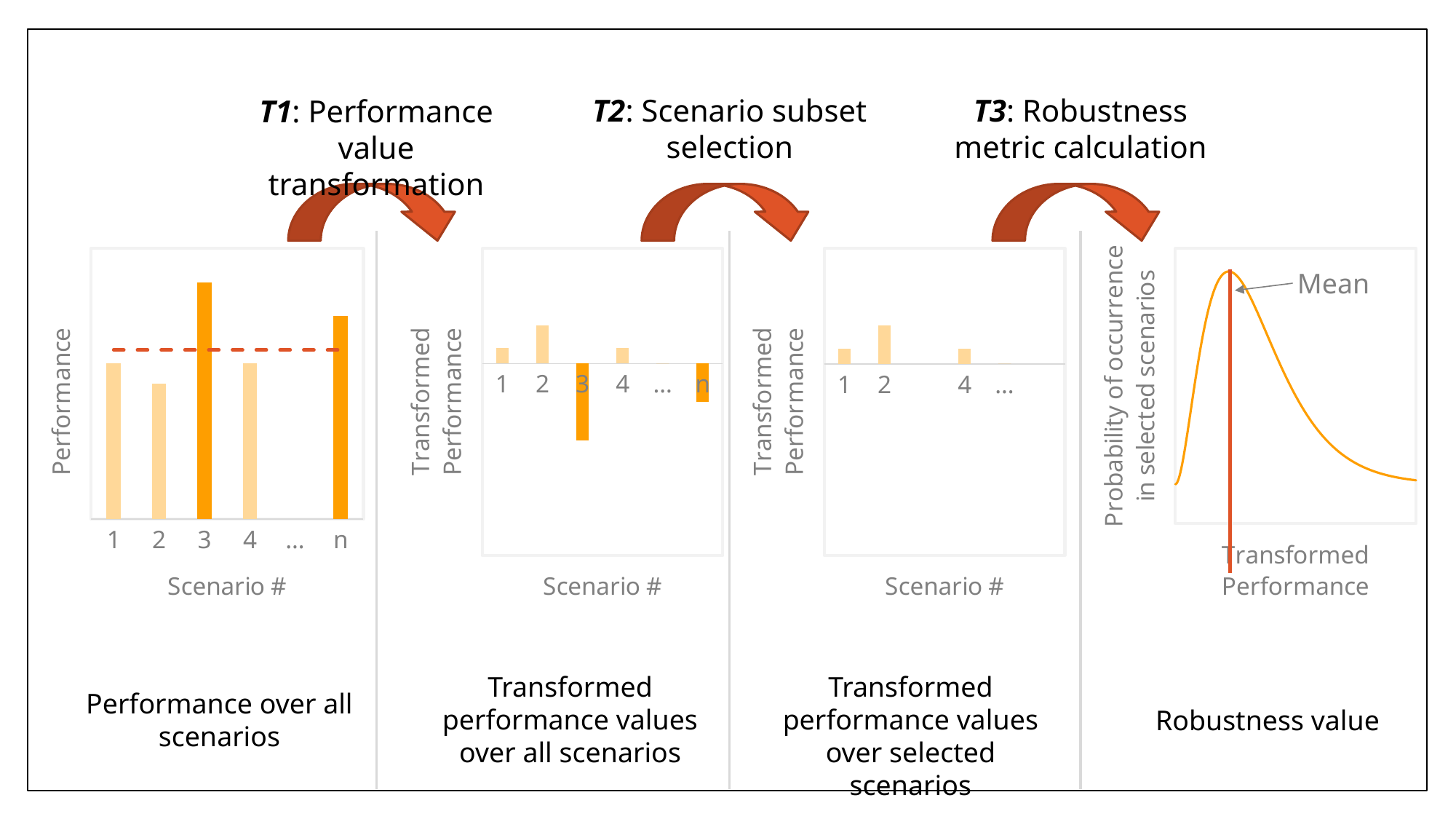
What is the y-axis label of the chart titled 'Robustness value'? Probability of occurrence in selected scenarios In the chart titled 'Transformed performance values over all scenarios', which scenario has the highest bar? 2 In the chart titled 'Transformed performance values over all scenarios', which scenario has the lowest (most negative) bar? 3 What kind of chart is the chart titled 'Robustness value'? Line chart In the chart titled 'Transformed performance values over selected scenarios', which scenario has the highest bar? 2 What kind of chart is the chart titled 'Performance over all scenarios'? Bar chart In the chart titled 'Performance over all scenarios', which scenario has the highest performance bar? 3 In the chart titled 'Transformed performance values over all scenarios', is the bar for scenario n above or below zero? Below In the chart titled 'Performance over all scenarios', which scenario has the lowest performance bar? 2 How many scenario bars are shown in the chart titled 'Transformed performance values over selected scenarios'? 3 How many labelled scenario bars are shown in the chart titled 'Performance over all scenarios'? 5 In the chart titled 'Performance over all scenarios', which bar is taller: scenario 3 or scenario n? Scenario 3